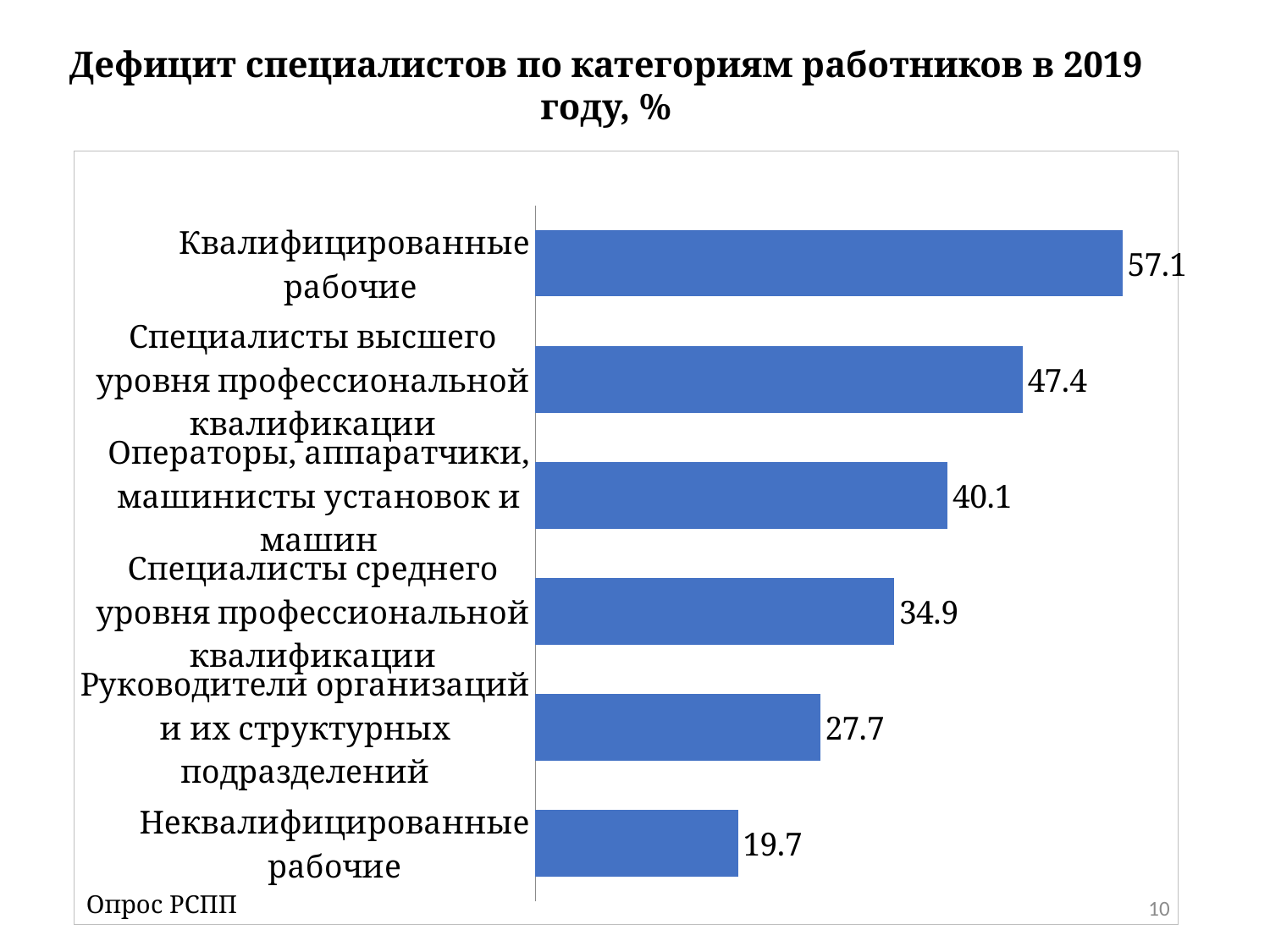
Which is larger: the value for Операторы, аппаратчики, машинисты установок и машин or the value for Руководители организаций и их структурных подразделений? Операторы, аппаратчики, машинисты установок и машин What is the value for Руководители организаций и их структурных подразделений? 27.7 What is the value for Неквалифицированные рабочие? 19.7 What is the title of the chart? Дефицит специалистов по категориям работников в 2019 году, % What kind of chart is shown on the slide? Bar chart What is the difference between the values for Специалисты высшего уровня профессиональной квалификации and Специалисты среднего уровня профессиональной квалификации? 12.5 Which category has the highest value? Квалифицированные рабочие What is the value for Операторы, аппаратчики, машинисты установок и машин? 40.1 Which category has the lowest value? Неквалифицированные рабочие What is the value for Квалифицированные рабочие? 57.1 What is the difference between the values for Квалифицированные рабочие and Неквалифицированные рабочие? 37.4 How many categories are shown in the chart? 6